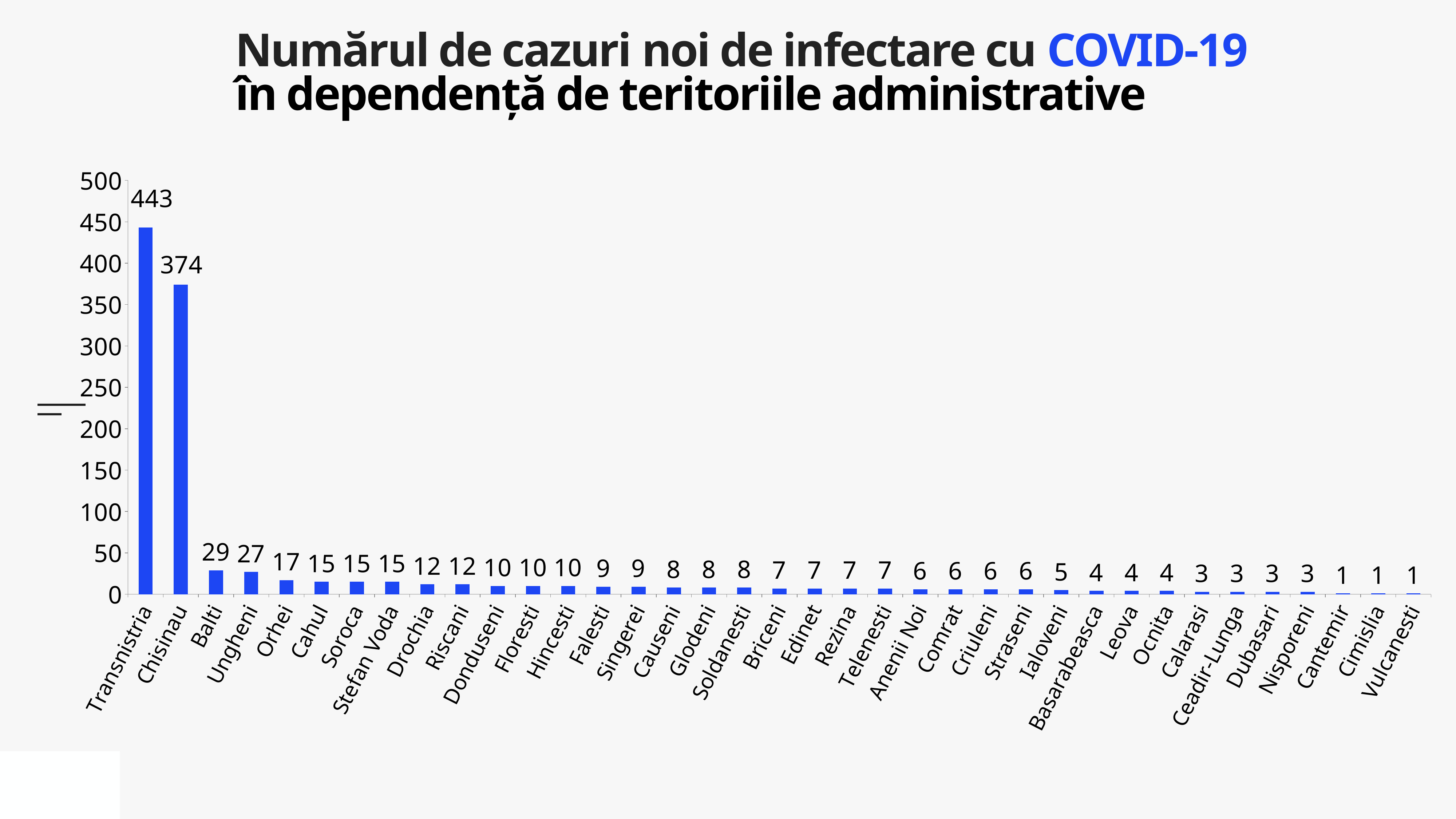
Is the value for Chisinau greater or less than 350? greater What is the value for Vulcanesti? 1 What is the value for Transnistria? 443 What is the difference between the values for Transnistria and Chisinau? 69 What is the value for Orhei? 17 How many territories are shown on the x axis? 37 Which territory has the highest number of new cases? Transnistria What is the value for Chisinau? 374 What kind of chart is shown on the slide? bar chart Do the values rise or fall from left to right along the x axis? fall Which is larger, the value for Balti or the value for Ungheni? Balti What is the value for Balti? 29